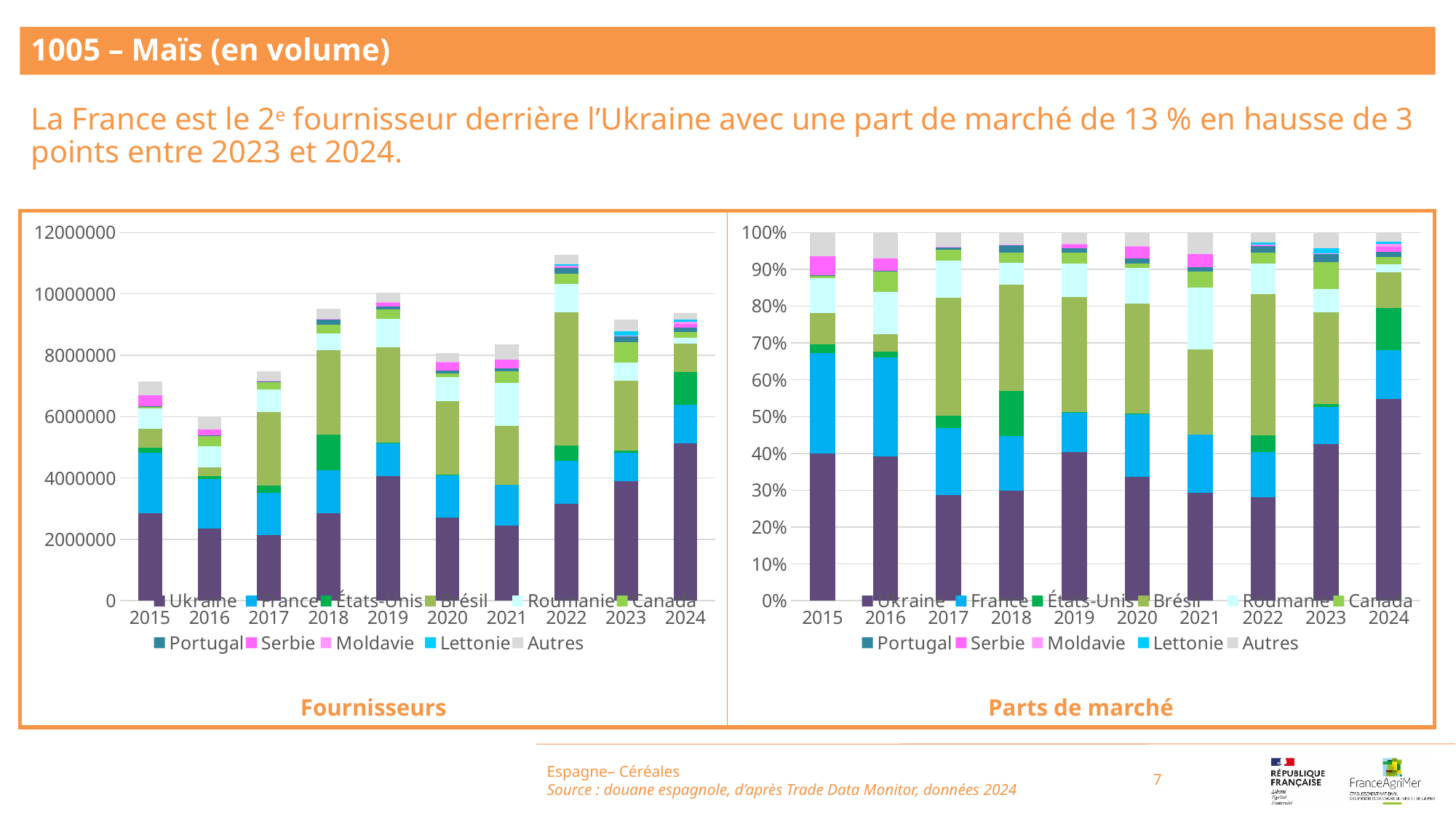
In the 'Fournisseurs' chart, which year has the tallest total bar? 2022 In the 'Parts de marché' chart, is the Ukraine share in 2024 greater or less than 50%? greater What kind of chart is the 'Fournisseurs' chart? Stacked bar chart In the 'Fournisseurs' chart, is the total bar for 2016 greater or less than 8000000? less In the 'Fournisseurs' chart, which year has the shortest total bar? 2016 What is the title of the chart on the right side of the slide? Parts de marché How many series does the legend of the 'Fournisseurs' chart list? 11 In the 'Fournisseurs' chart, is the total bar for 2022 greater or less than 10000000? greater In the 'Parts de marché' chart, does the Ukraine share rise or fall from 2022 to 2024? rise How many years are shown on the x axis of the 'Parts de marché' chart? 10 In the 'Parts de marché' chart, is the Ukraine share larger in 2024 or in 2023? 2024 In the 'Fournisseurs' chart, is the total bar for 2022 larger or smaller than the total bar for 2023? larger